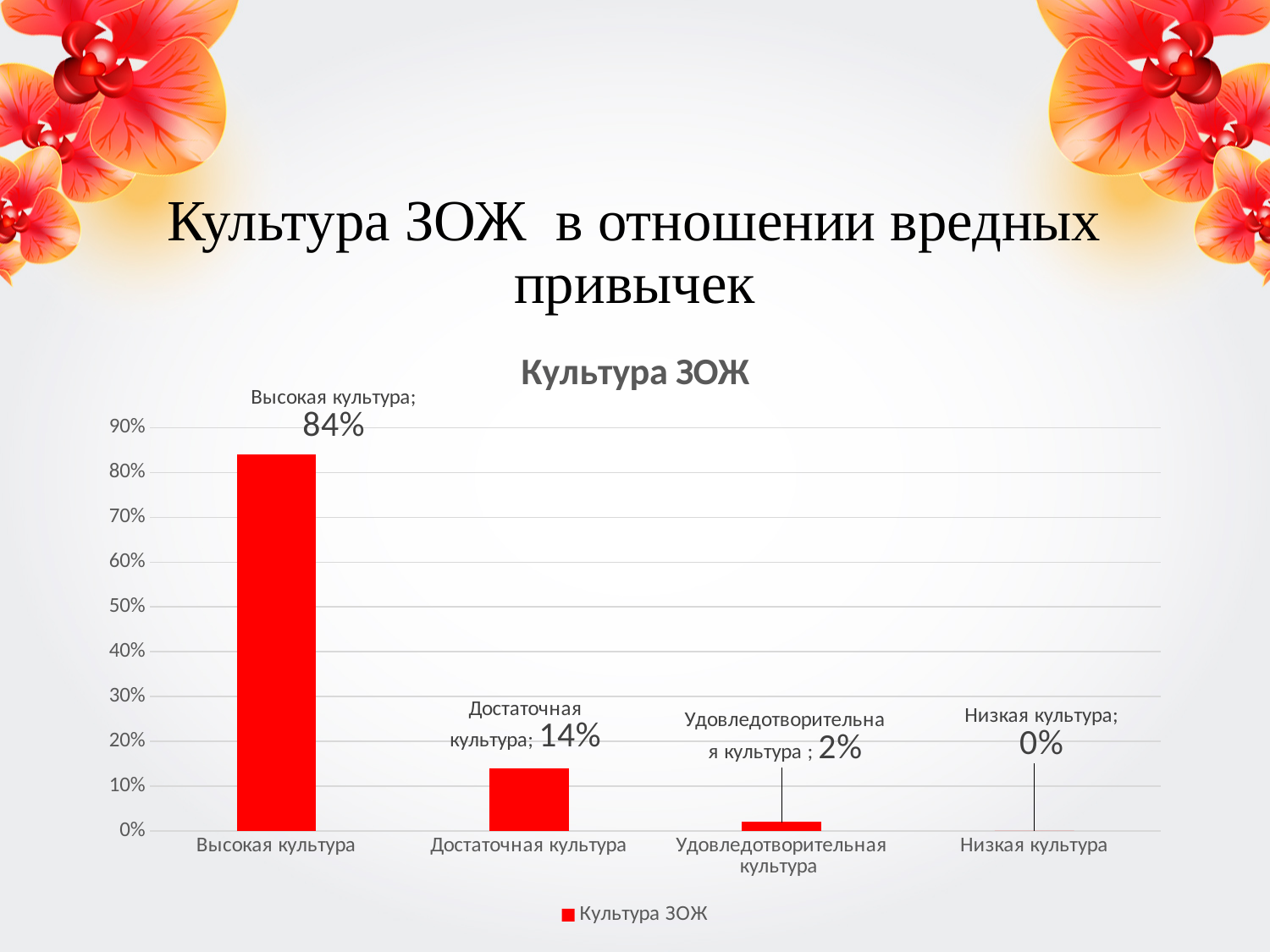
What is the title of the chart? Культура ЗОЖ What is the value for Низкая культура? 0% Which is larger, the value for Достаточная культура or the value for Удовледотворительная культура? Достаточная культура What is the value for Высокая культура? 84% How many categories are shown on the x axis? 4 Is the value for Высокая культура greater or less than 80%? greater Which category has the highest value? Высокая культура Which category has the lowest value? Низкая культура What is the value for Удовледотворительная культура? 2% What kind of chart is shown on the slide? bar chart What is the value for Достаточная культура? 14% What is the difference between the values for Высокая культура and Достаточная культура? 70%